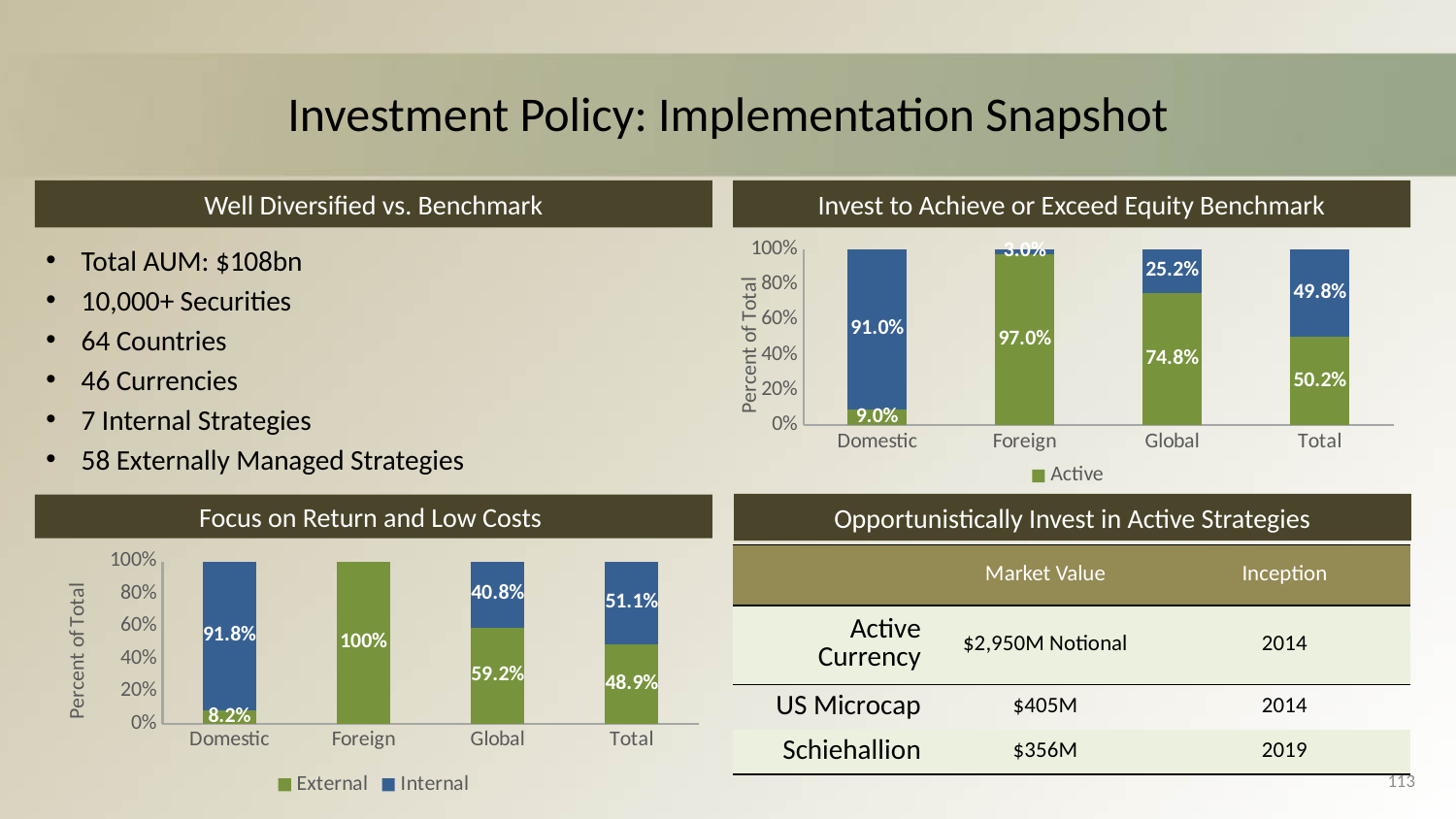
In the 'Invest to Achieve or Exceed Equity Benchmark' chart, what is the Active value for Global? 74.8% In the 'Invest to Achieve or Exceed Equity Benchmark' chart, which category has the highest Active value? Foreign In the 'Focus on Return and Low Costs' chart, how many series does the legend list? 2 In the 'Focus on Return and Low Costs' chart, what is the External value for Domestic? 8.2% In the 'Invest to Achieve or Exceed Equity Benchmark' chart, what is the Active value for Domestic? 9.0% In the 'Focus on Return and Low Costs' chart, what is the difference between the Internal values for Domestic and Total? 40.7% In the 'Focus on Return and Low Costs' chart, which category has the highest External value? Foreign In the 'Focus on Return and Low Costs' chart, what is the Internal value for Global? 40.8% What kind of chart is 'Focus on Return and Low Costs'? stacked bar chart In the 'Invest to Achieve or Exceed Equity Benchmark' chart, how many categories are shown on the x axis? 4 In the 'Invest to Achieve or Exceed Equity Benchmark' chart, is the Active value for Total larger or smaller than the Active value for Global? smaller In the 'Focus on Return and Low Costs' chart, which category has the lowest External value? Domestic